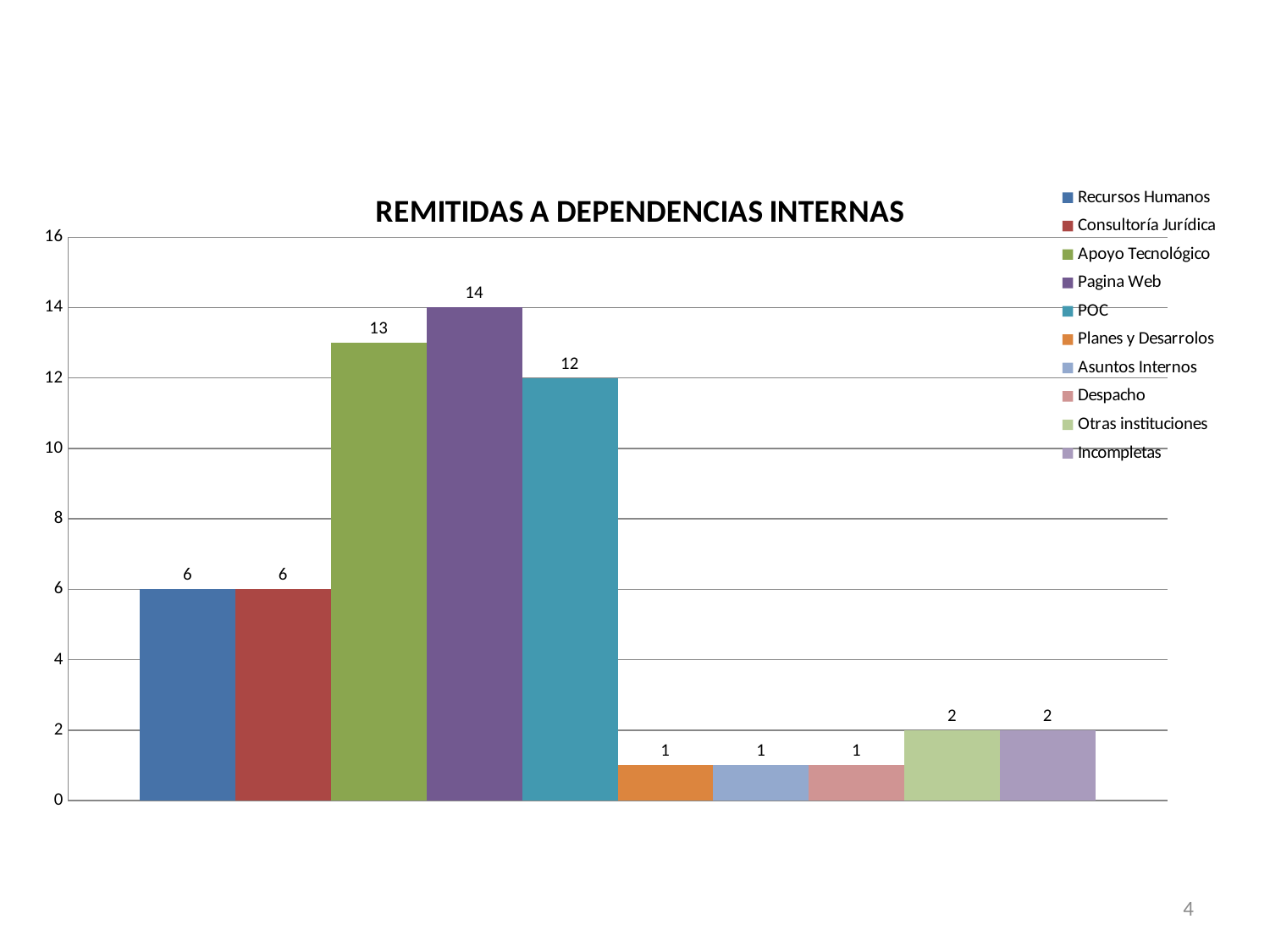
How many series does the legend list? 10 Which is larger, the value for POC or the value for Recursos Humanos? POC What is the value for Pagina Web? 14 What is the difference between the values for Pagina Web and POC? 2 What is the difference between the values for Apoyo Tecnológico and Consultoría Jurídica? 7 What is the value for Recursos Humanos? 6 Which series has the highest value? Pagina Web What is the value for Otras instituciones? 2 What is the value for Apoyo Tecnológico? 13 What is the title of the chart? REMITIDAS A DEPENDENCIAS INTERNAS What kind of chart is shown on the slide? Bar chart What is the value for POC? 12